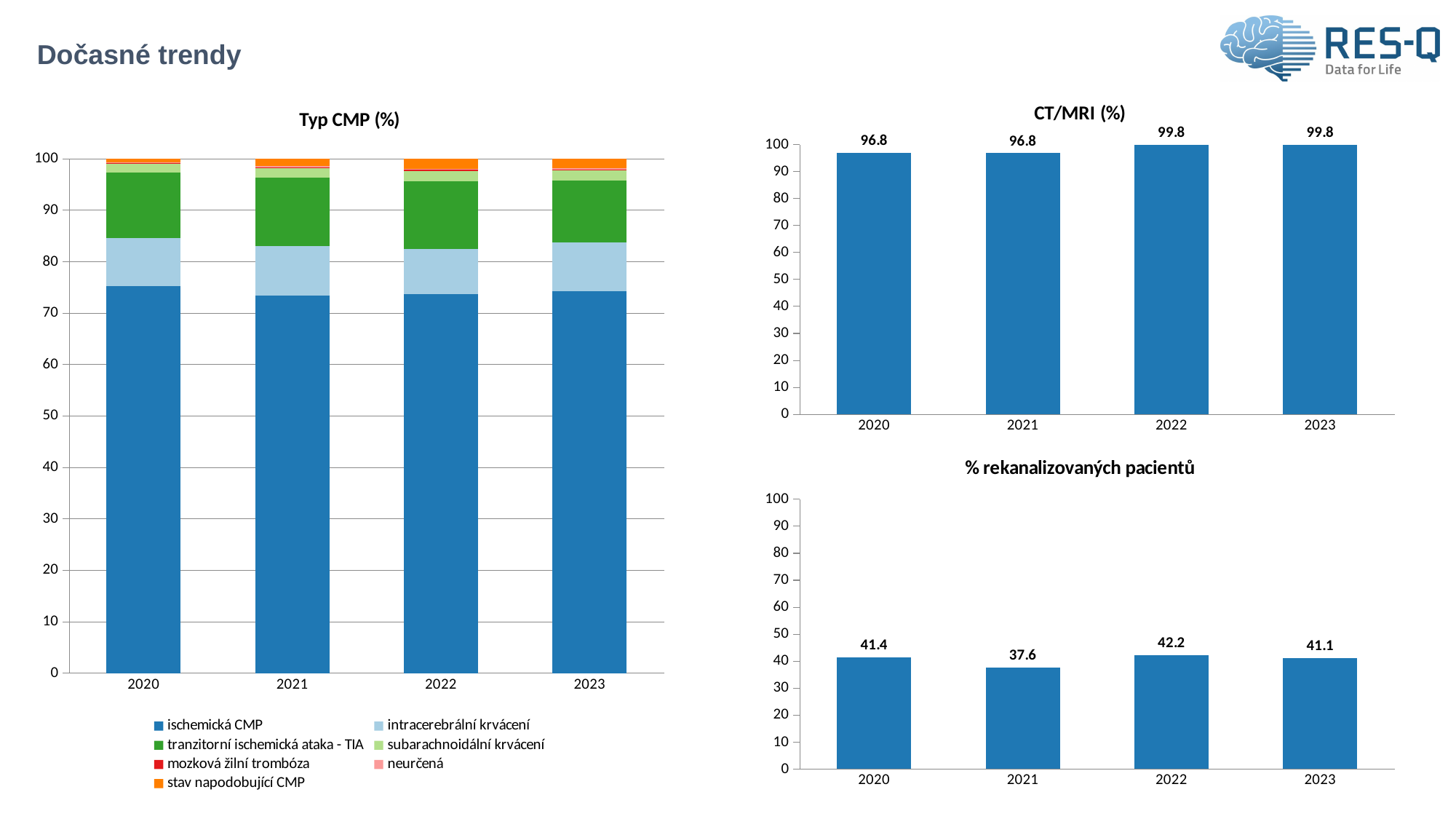
In the % rekanalizovaných pacientů chart, which year has the highest value? 2022 In the Typ CMP (%) chart, is the value for ischemická CMP in 2020 greater or less than 70? greater In the Typ CMP (%) chart, how many series does the legend list? 7 In the % rekanalizovaných pacientů chart, what is the value for 2021? 37.6 In the % rekanalizovaných pacientů chart, which is larger, the value for 2020 or the value for 2023? 2020 In the Typ CMP (%) chart, how many years are shown on the x axis? 4 What kind of chart is the Typ CMP (%) chart? stacked bar chart In the CT/MRI (%) chart, what is the value for 2022? 99.8 In the % rekanalizovaných pacientů chart, which year has the lowest value? 2021 In the % rekanalizovaných pacientů chart, what is the difference between the values for 2022 and 2021? 4.6 In the CT/MRI (%) chart, what is the difference between the values for 2023 and 2020? 3 In the CT/MRI (%) chart, what is the value for 2020? 96.8